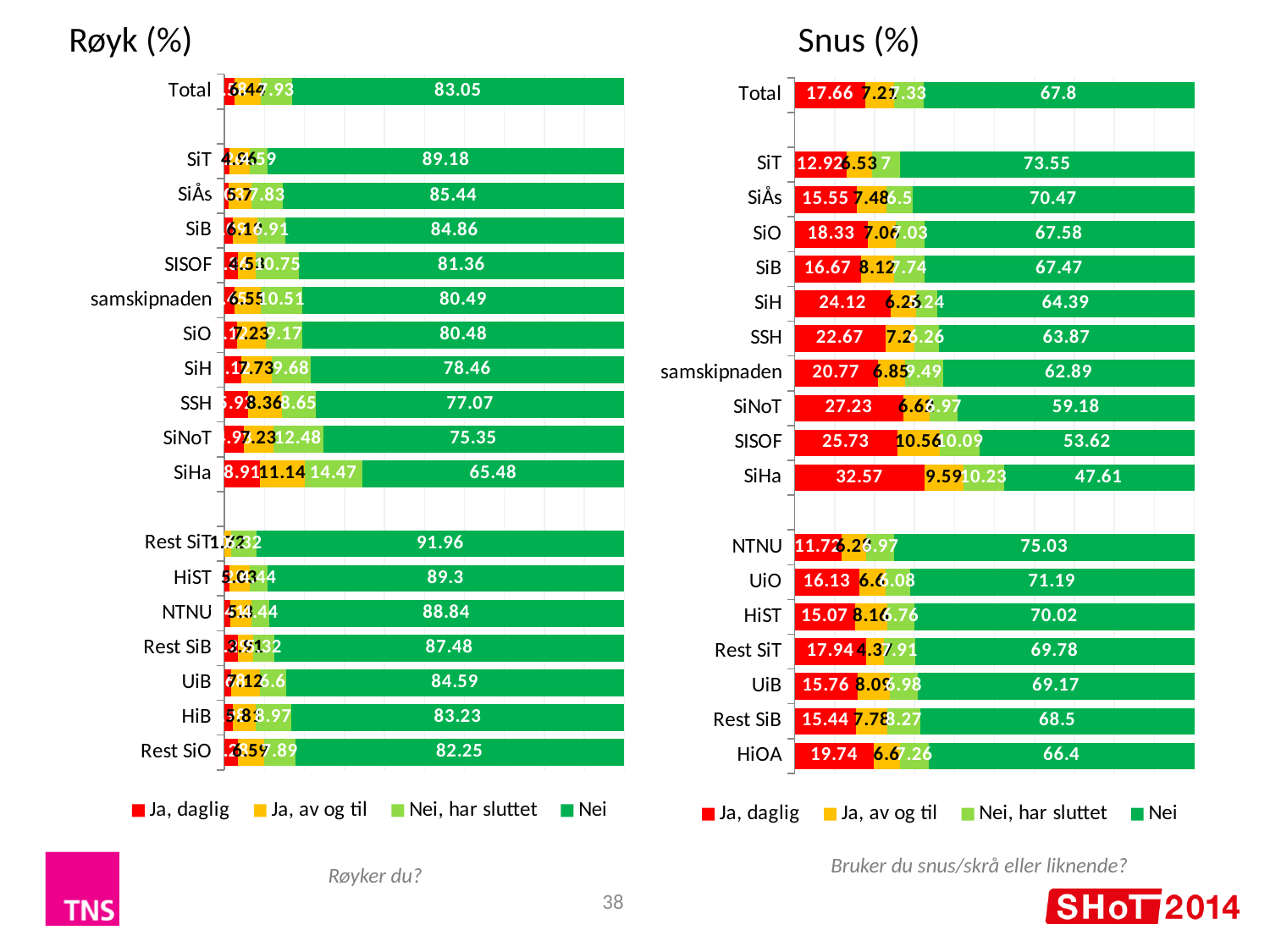
In the Røyk (%) chart, what is the value of the 'Nei' segment for Total? 83.05 In the Snus (%) chart, what is the 'Ja, daglig' value for SiHa? 32.57 How many series does the legend of the Røyk (%) chart list? 4 In the Snus (%) chart, which category has the highest 'Ja, daglig' value? SiHa In the Snus (%) chart, what is the 'Ja, daglig' value for SISOF? 25.73 What kind of chart is the Snus (%) chart? Stacked bar chart In the Røyk (%) chart, what is the difference between the 'Nei' values for Rest SiT and SiHa? 26.48 In the Snus (%) chart, what is the difference between the 'Nei' values for SiT and SiHa? 25.94 In the Snus (%) chart, which has the larger 'Nei' value, SiH or SSH? SiH In the Røyk (%) chart, which category has the highest 'Nei' value? Rest SiT In the Snus (%) chart, what is the 'Nei' value for SiHa? 47.61 In the Røyk (%) chart, which category has the lowest 'Nei' value? SiHa